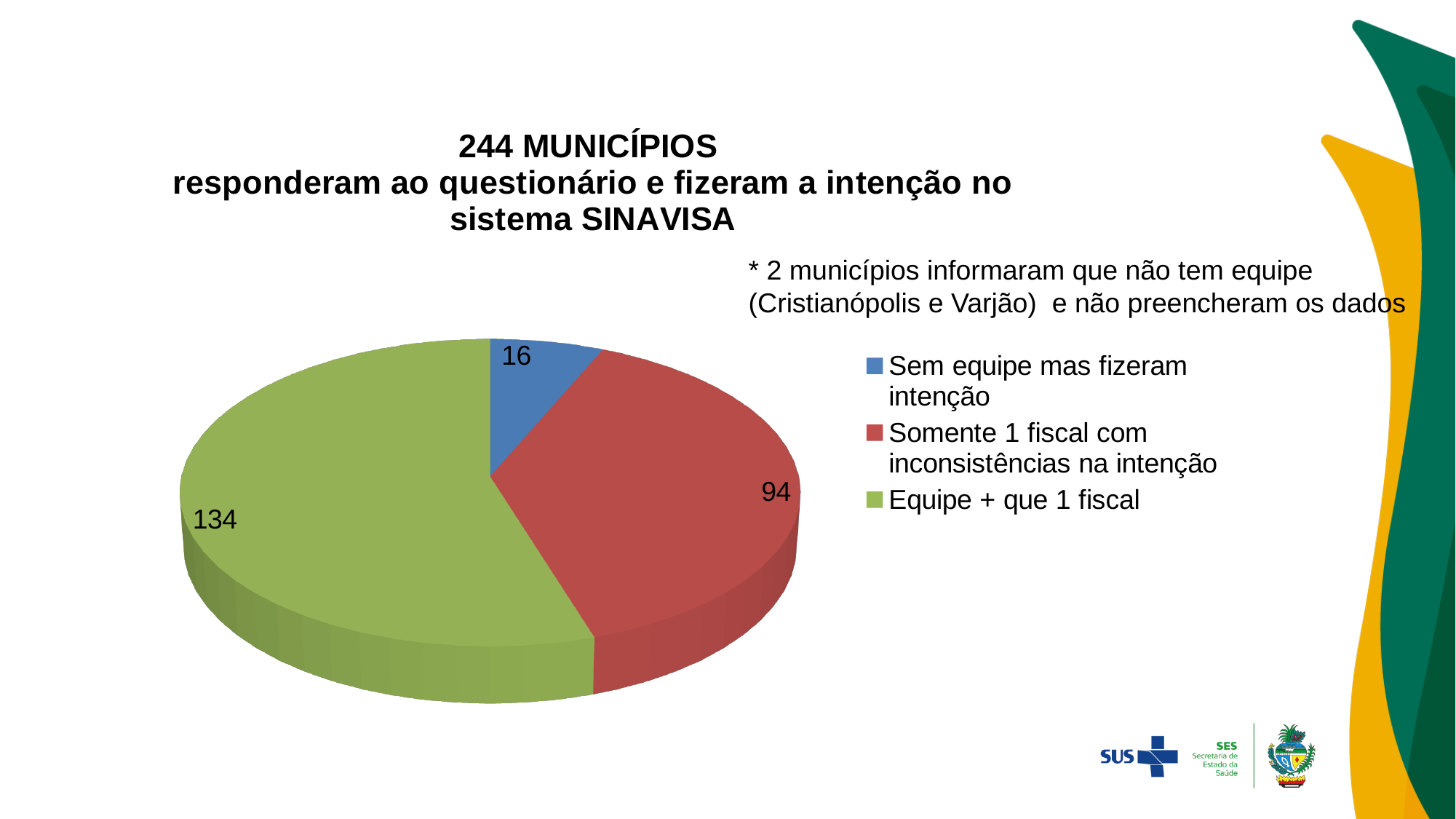
Which is larger: the value for "Somente 1 fiscal com inconsistências na intenção" or the value for "Sem equipe mas fizeram intenção"? Somente 1 fiscal com inconsistências na intenção What kind of chart is shown on the slide? Pie chart What is the difference between the values for "Equipe + que 1 fiscal" and "Somente 1 fiscal com inconsistências na intenção"? 40 What is the value for "Somente 1 fiscal com inconsistências na intenção" in the pie chart? 94 What is the total of all three slices in the pie chart? 244 What is the value for "Equipe + que 1 fiscal" in the pie chart? 134 Which category has the largest slice in the pie chart? Equipe + que 1 fiscal Which category has the smallest slice in the pie chart? Sem equipe mas fizeram intenção Which colour represents "Equipe + que 1 fiscal" in the pie chart? Green What is the value for "Sem equipe mas fizeram intenção" in the pie chart? 16 How many entries does the legend of the pie chart list? 3 How many slices does the pie chart have? 3